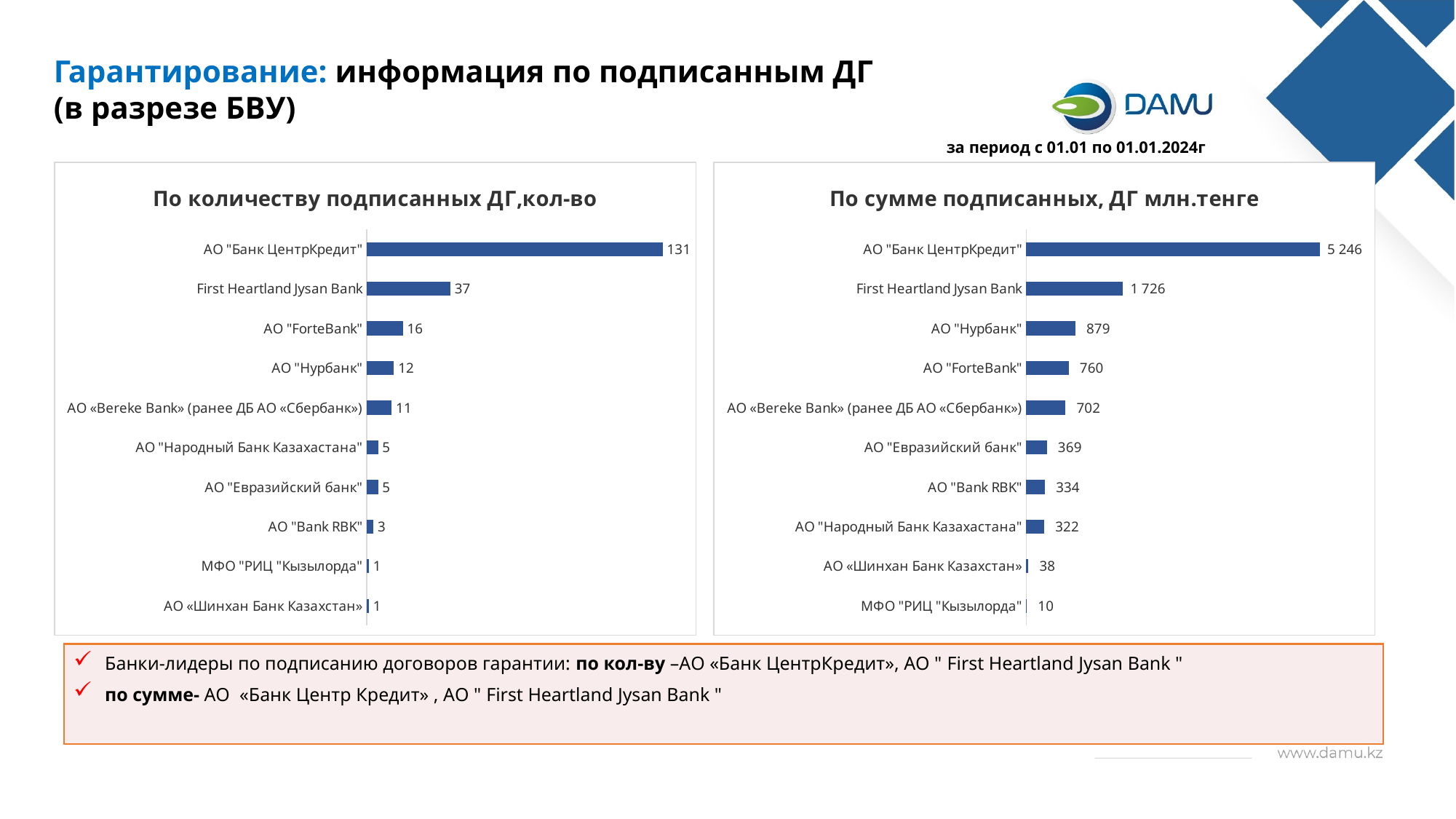
In the chart "По количеству подписанных ДГ,кол-во", what is the value for АО "Банк ЦентрКредит"? 131 What kind of chart is "По сумме подписанных, ДГ млн.тенге"? Bar chart In the chart "По количеству подписанных ДГ,кол-во", what is the value for АО "ForteBank"? 16 In the chart "По сумме подписанных, ДГ млн.тенге", which bank has the lowest value? МФО "РИЦ "Кызылорда" In the chart "По сумме подписанных, ДГ млн.тенге", what is the value for АО "Нурбанк"? 879 In the chart "По сумме подписанных, ДГ млн.тенге", what is the value for First Heartland Jysan Bank? 1 726 In the chart "По сумме подписанных, ДГ млн.тенге", what is the difference between АО "ForteBank" and АО «Bereke Bank» (ранее ДБ АО «Сбербанк»)? 58 In the chart "По сумме подписанных, ДГ млн.тенге", which is larger: АО "Евразийский банк" or АО "Народный Банк Казахастана"? АО "Евразийский банк" In the chart "По количеству подписанных ДГ,кол-во", what is the difference between АО "Банк ЦентрКредит" and First Heartland Jysan Bank? 94 How many banks are shown in the chart "По количеству подписанных ДГ,кол-во"? 10 What is the title of the chart on the left side of the slide? По количеству подписанных ДГ,кол-во In the chart "По количеству подписанных ДГ,кол-во", which bank has the highest value? АО "Банк ЦентрКредит"